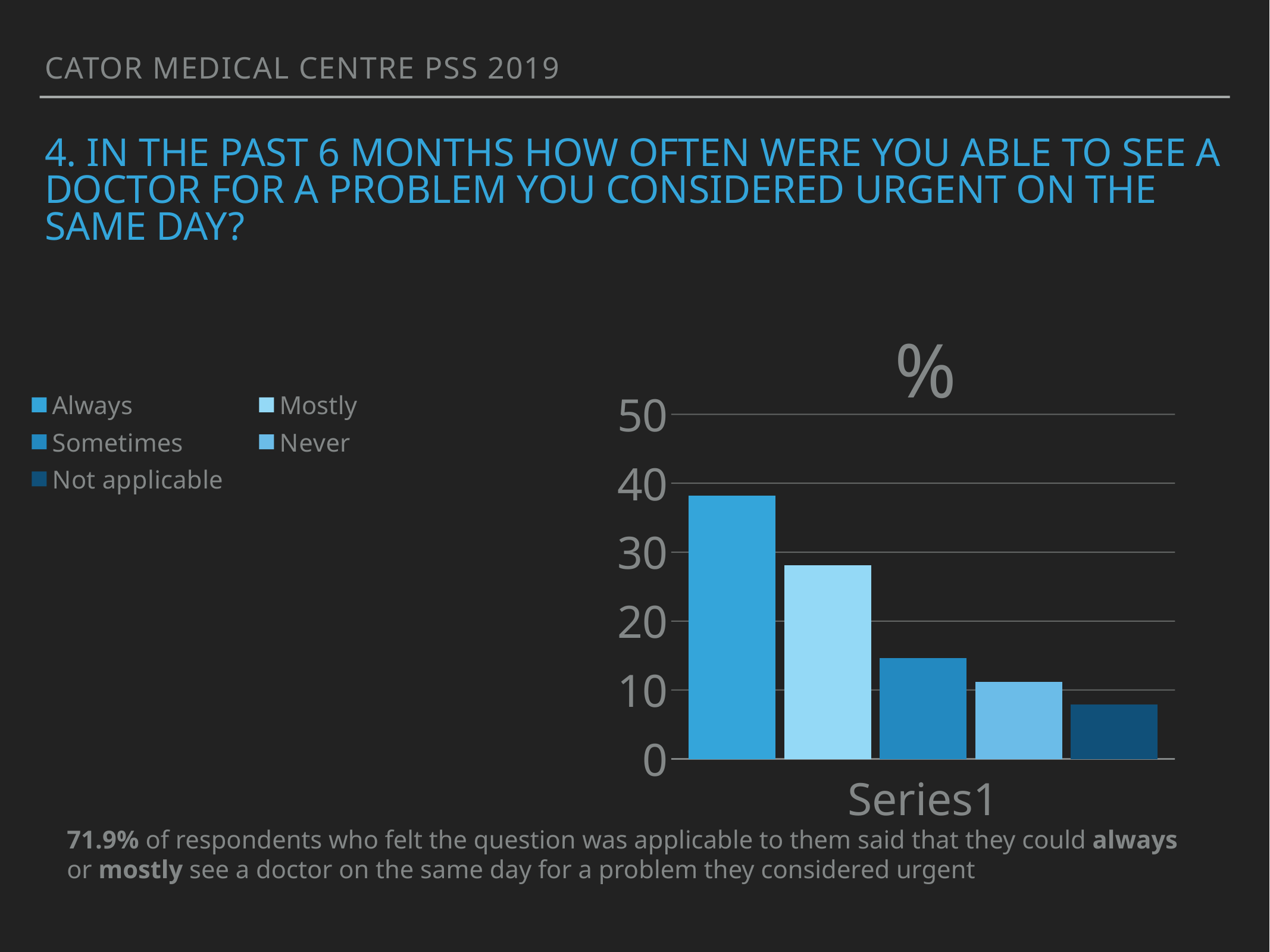
How many bars are plotted in the chart? 5 Is the value for Sometimes greater or less than 20? less Is the value for Mostly greater or less than 30? less Which category has the highest value in the chart? Always Which category has the lowest value in the chart? Not applicable Which is larger, the value for Sometimes or the value for Not applicable? Sometimes What kind of chart is shown on the slide? bar chart How many entries does the chart legend list? 5 What is the title of the chart? % Is the value for Always greater or less than 30? greater Which is larger, the value for Always or the value for Mostly? Always